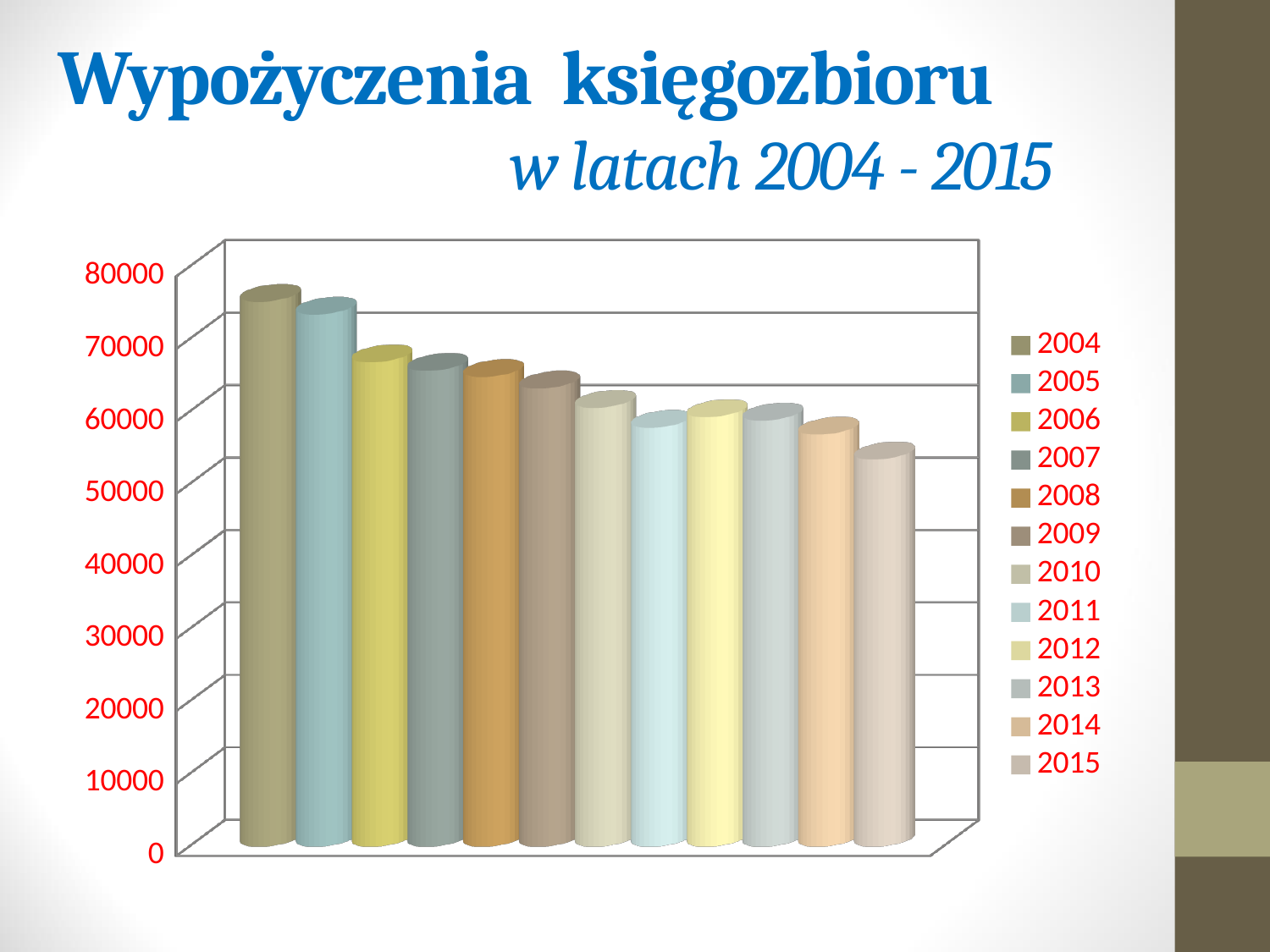
What kind of chart is shown on the slide? bar chart Is the value for 2004 greater or less than 70000? greater Which is larger, the value for 2006 or the value for 2014? 2006 Is the value for 2006 greater or less than 60000? greater Do the values generally rise or fall from 2004 to 2015? fall How many entries does the legend list? 12 What is the title of the slide containing the chart? Wypożyczenia księgozbioru w latach 2004 - 2015 Is the value for 2015 greater or less than 60000? less How many bars (years) are plotted in the chart? 12 Which year has the lowest value in the chart? 2015 Which year has the highest value in the chart? 2004